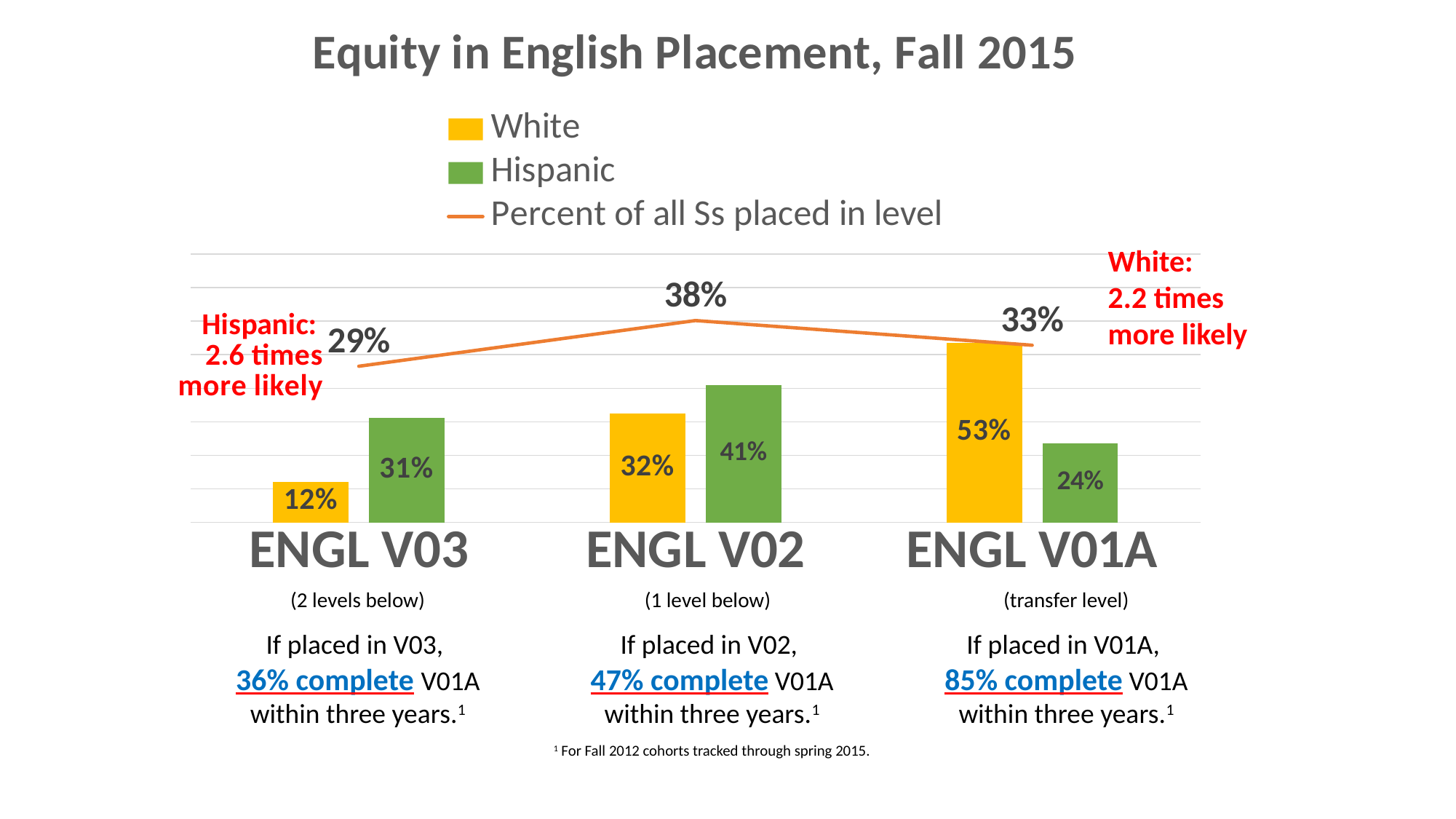
What is the title of the chart? Equity in English Placement, Fall 2015 What is the difference between the Hispanic and White values in ENGL V03? 19% What is the 'Percent of all Ss placed in level' value for ENGL V02? 38% What is the value for White in ENGL V03? 12% What kind of chart is this? Bar chart with a line Which is larger in ENGL V01A, the White value or the Hispanic value? White How many levels (categories) are shown on the x axis? 3 How many series does the legend list? 3 What is the value for White in ENGL V01A? 53% In which level is the White bar highest? ENGL V01A What is the value for Hispanic in ENGL V02? 41% In which level is the Hispanic bar lowest? ENGL V01A